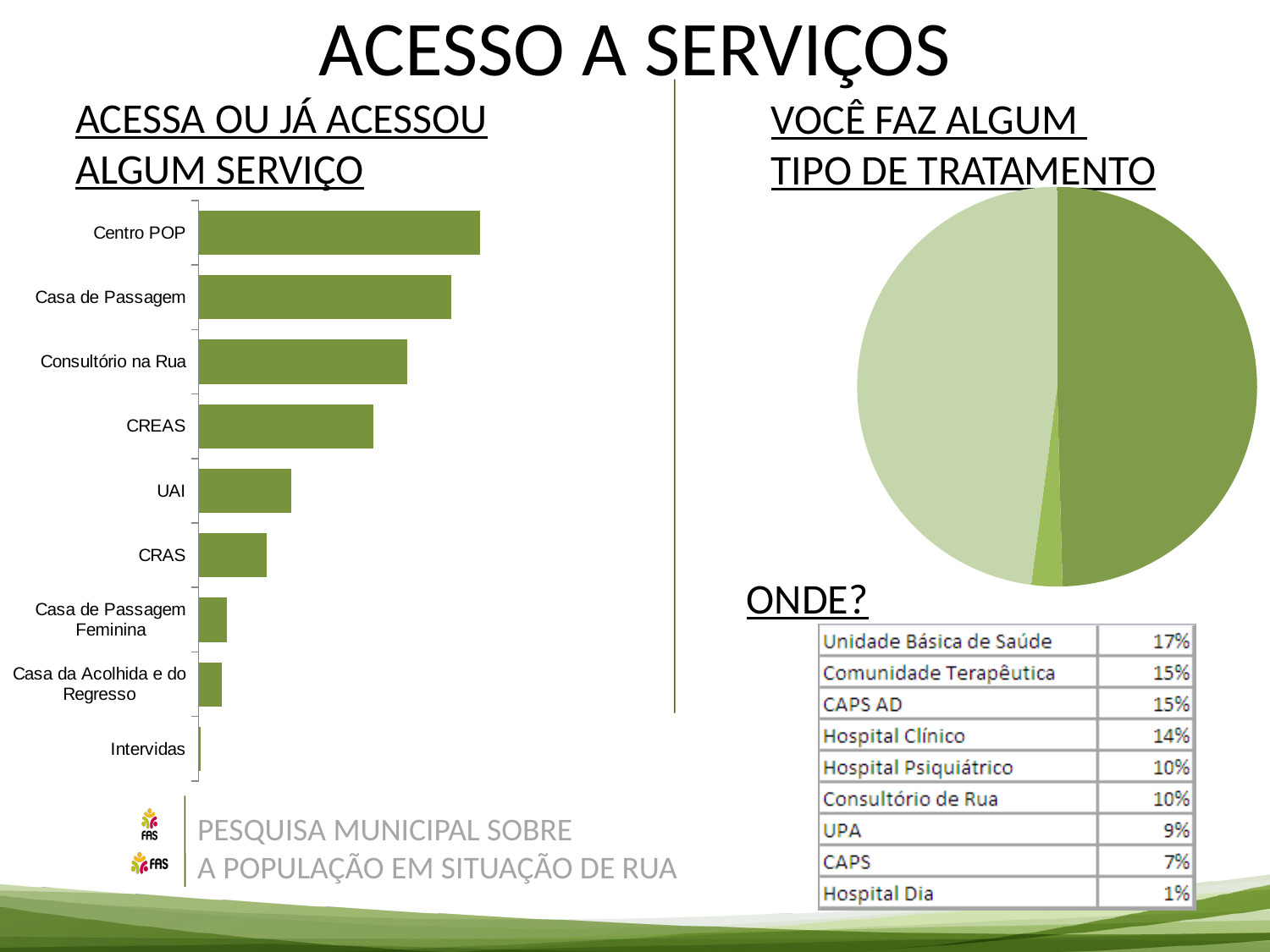
In the 'ACESSA OU JÁ ACESSOU ALGUM SERVIÇO' bar chart, which service has the shortest bar? Intervidas In the 'ACESSA OU JÁ ACESSOU ALGUM SERVIÇO' bar chart, which is larger: Centro POP or CREAS? Centro POP In the 'ACESSA OU JÁ ACESSOU ALGUM SERVIÇO' bar chart, which is larger: Casa de Passagem or Consultório na Rua? Casa de Passagem What kind of chart is the 'ACESSA OU JÁ ACESSOU ALGUM SERVIÇO' chart? bar chart How many services are listed in the 'ACESSA OU JÁ ACESSOU ALGUM SERVIÇO' bar chart? 9 How many slices does the 'VOCÊ FAZ ALGUM TIPO DE TRATAMENTO' pie chart have? 3 In the 'ACESSA OU JÁ ACESSOU ALGUM SERVIÇO' bar chart, which is larger: CRAS or Casa de Passagem Feminina? CRAS What kind of chart is the 'VOCÊ FAZ ALGUM TIPO DE TRATAMENTO' chart? pie chart What is the title of the pie chart on the right side of the slide? VOCÊ FAZ ALGUM TIPO DE TRATAMENTO In the 'ACESSA OU JÁ ACESSOU ALGUM SERVIÇO' bar chart, do the bars get longer or shorter going from the top category to the bottom category? shorter In the 'ACESSA OU JÁ ACESSOU ALGUM SERVIÇO' bar chart, which service has the longest bar? Centro POP